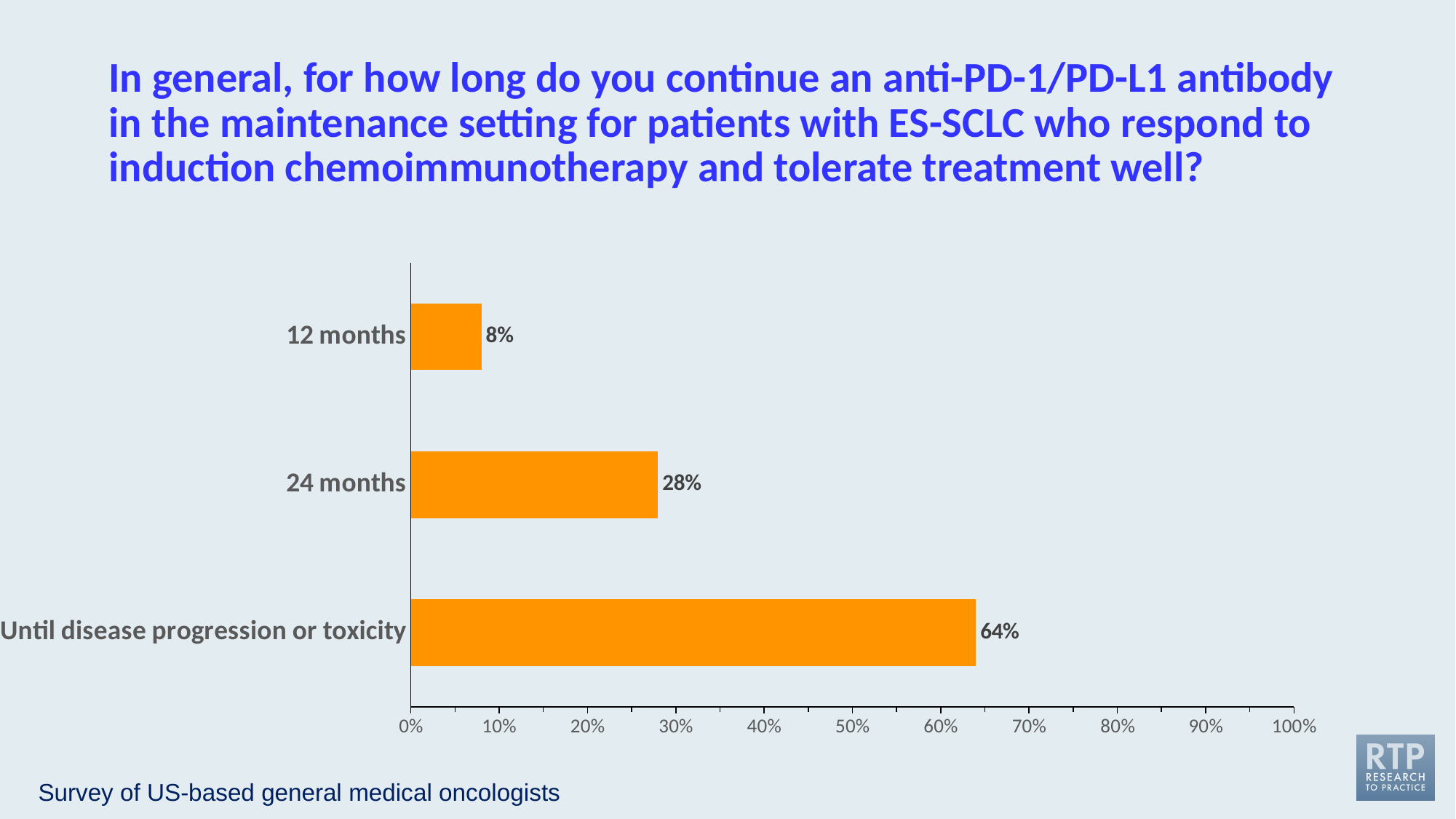
Which response option has the lowest percentage? 12 months What kind of chart is shown on the slide? Bar chart What is the difference in percentage points between "Until disease progression or toxicity" and "24 months"? 36 Which response option has the highest percentage? Until disease progression or toxicity Is the value for "Until disease progression or toxicity" greater or less than 50%? greater What is the difference in percentage points between "24 months" and "12 months"? 20 Which has a larger value, "24 months" or "12 months"? 24 months How many response options are shown in the chart? 3 What percentage of respondents chose "24 months"? 28% What percentage of respondents chose "Until disease progression or toxicity"? 64% What percentage of respondents chose "12 months"? 8% What is the maximum value shown on the horizontal axis? 100%